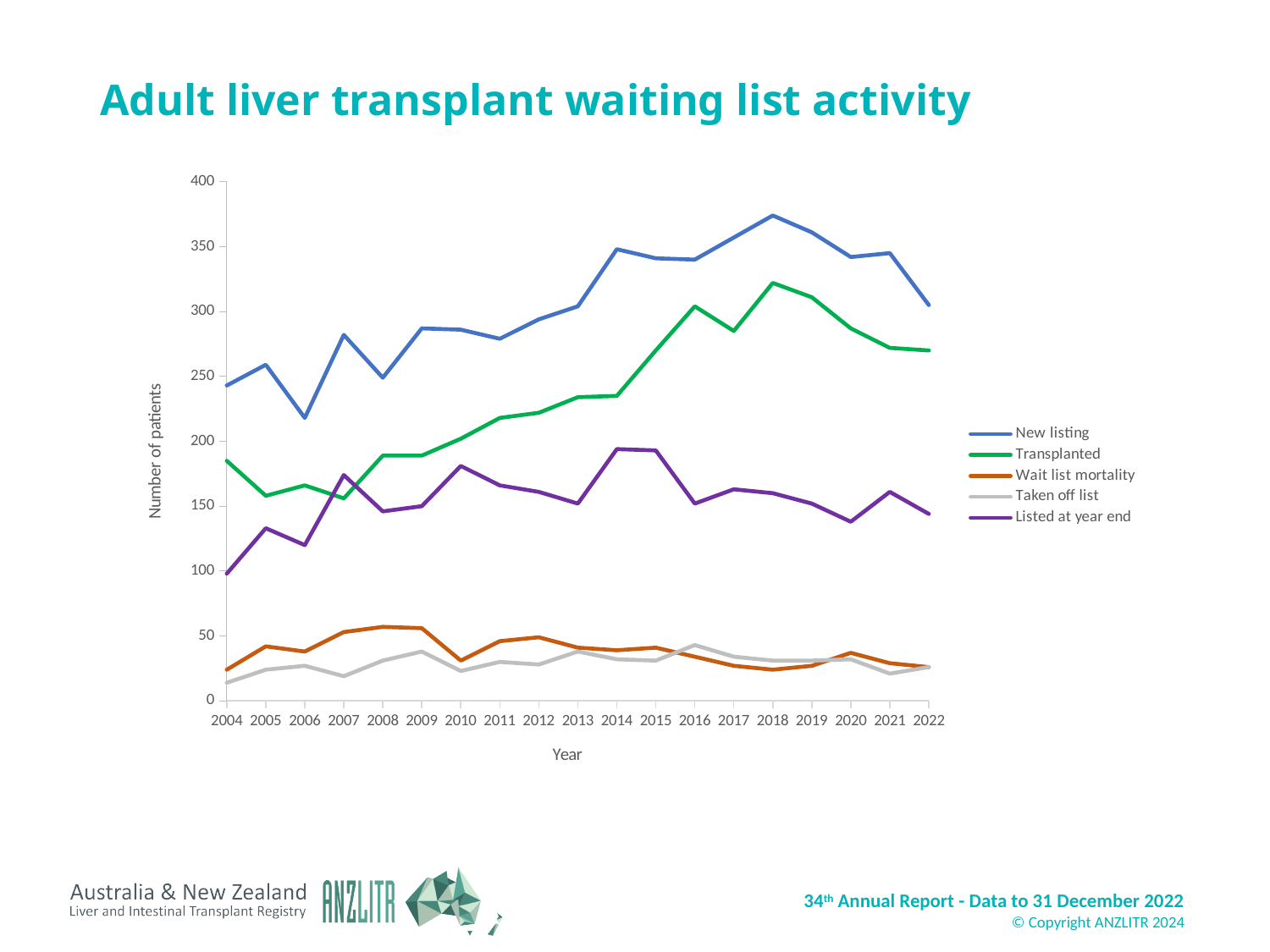
How many years are shown on the x axis? 19 In which year is the New listing series at its lowest? 2006 In which year is the New listing series at its highest? 2018 In 2022, which is larger: New listing or Transplanted? New listing How many series does the legend list? 5 What kind of chart is shown on the slide? line chart Is the value for Transplanted in 2004 greater or less than 200? less Is the value for Listed at year end in 2014 greater or less than 150? greater What is the label on the vertical axis? Number of patients Is the value for New listing in 2018 greater or less than 350? greater In which year is the Transplanted series at its highest? 2018 In which year is the Listed at year end series at its lowest? 2004